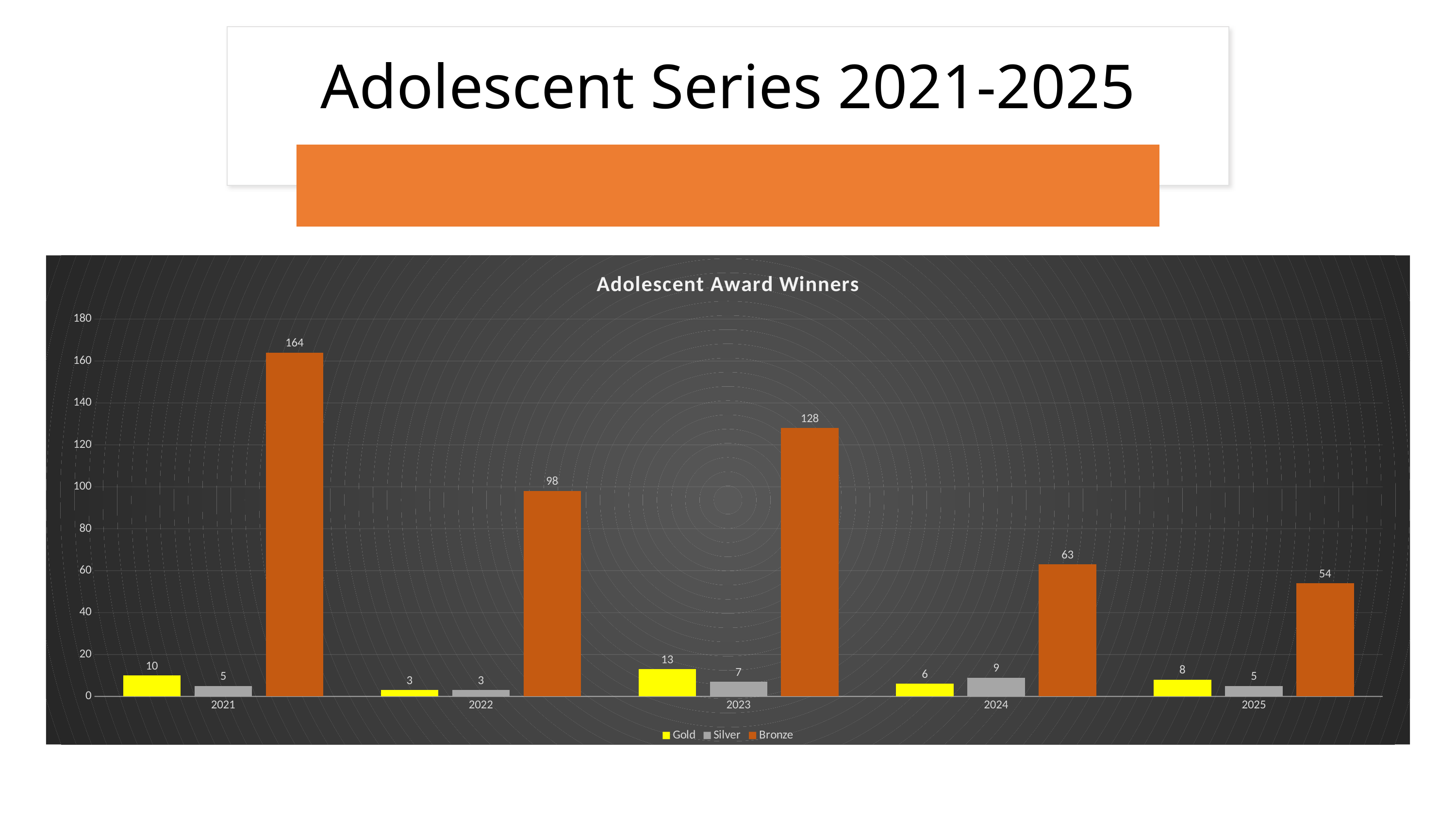
Which year has the lowest Gold value? 2022 What is the difference between the Bronze values for 2021 and 2023? 36 What is the Silver value for 2024? 9 What is the Bronze value for 2021? 164 What is the title of the chart? Adolescent Award Winners What kind of chart is shown? bar chart How many series does the legend list? 3 Which year has the highest Bronze value? 2021 Which is larger, the Bronze value for 2022 or the Bronze value for 2024? 2022 Is the Bronze value for 2025 greater or less than 60? less How many years are shown on the x axis? 5 What is the Gold value for 2023? 13